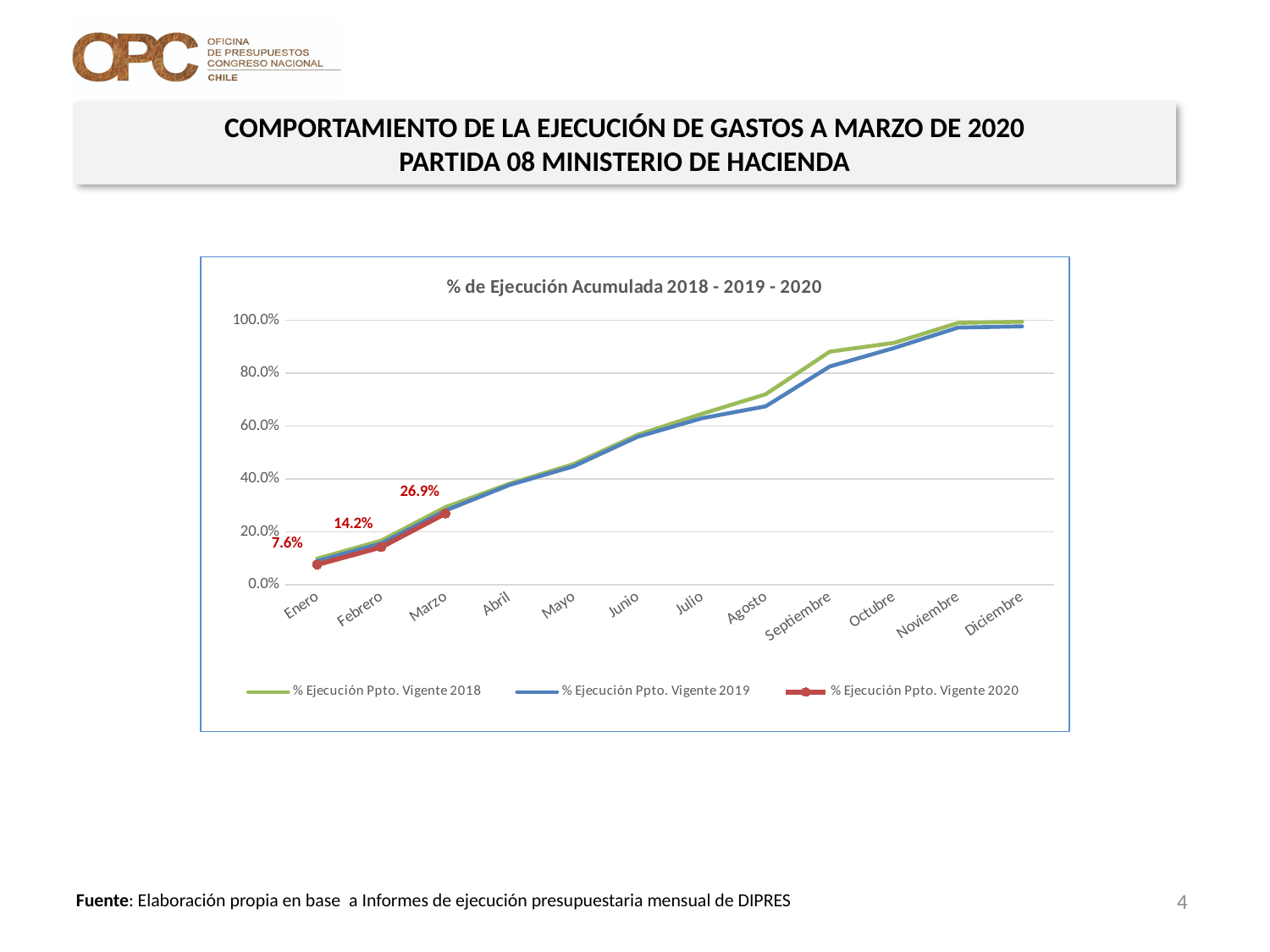
How many months are shown on the x axis? 12 Do the values for % Ejecución Ppto. Vigente 2019 rise or fall from Enero to Diciembre? Rise What is the difference between the 2020 values for Febrero and Enero? 6.6% What is the title of the chart? % de Ejecución Acumulada 2018 - 2019 - 2020 What is the value for % Ejecución Ppto. Vigente 2020 in Marzo? 26.9% What kind of chart is shown on the slide? Line chart What is the difference between the 2020 values for Marzo and Febrero? 12.7% Which month has the highest value for % Ejecución Ppto. Vigente 2020? Marzo What is the value for % Ejecución Ppto. Vigente 2020 in Enero? 7.6% What is the value for % Ejecución Ppto. Vigente 2020 in Febrero? 14.2% Is the value for % Ejecución Ppto. Vigente 2019 in Agosto greater or less than 80.0%? less How many series does the legend list? 3